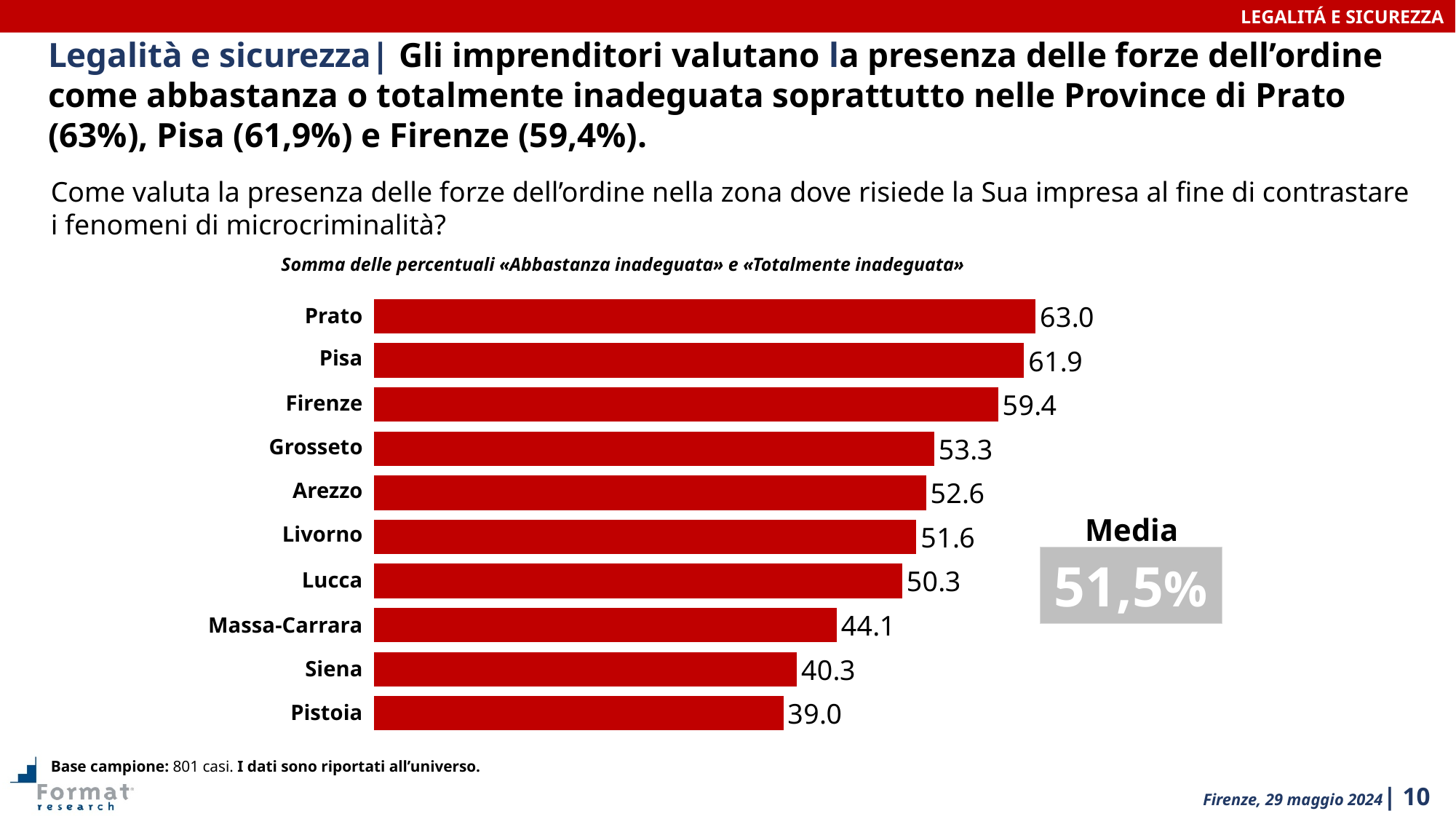
Which province has the lowest value? Pistoia Which province has the highest value? Prato Which is larger, the value for Siena or the value for Massa-Carrara? Massa-Carrara What is the value for Livorno? 51.6 What is the difference between the values for Firenze and Grosseto? 6.1 What is the 'Media' (average) value shown next to the chart? 51,5% What is the difference between the values for Prato and Pistoia? 24.0 What kind of chart is shown on the slide? Bar chart What is the value for Prato? 63.0 What colour are the bars in the chart? Red What is the value for Massa-Carrara? 44.1 How many provinces are shown in the chart? 10